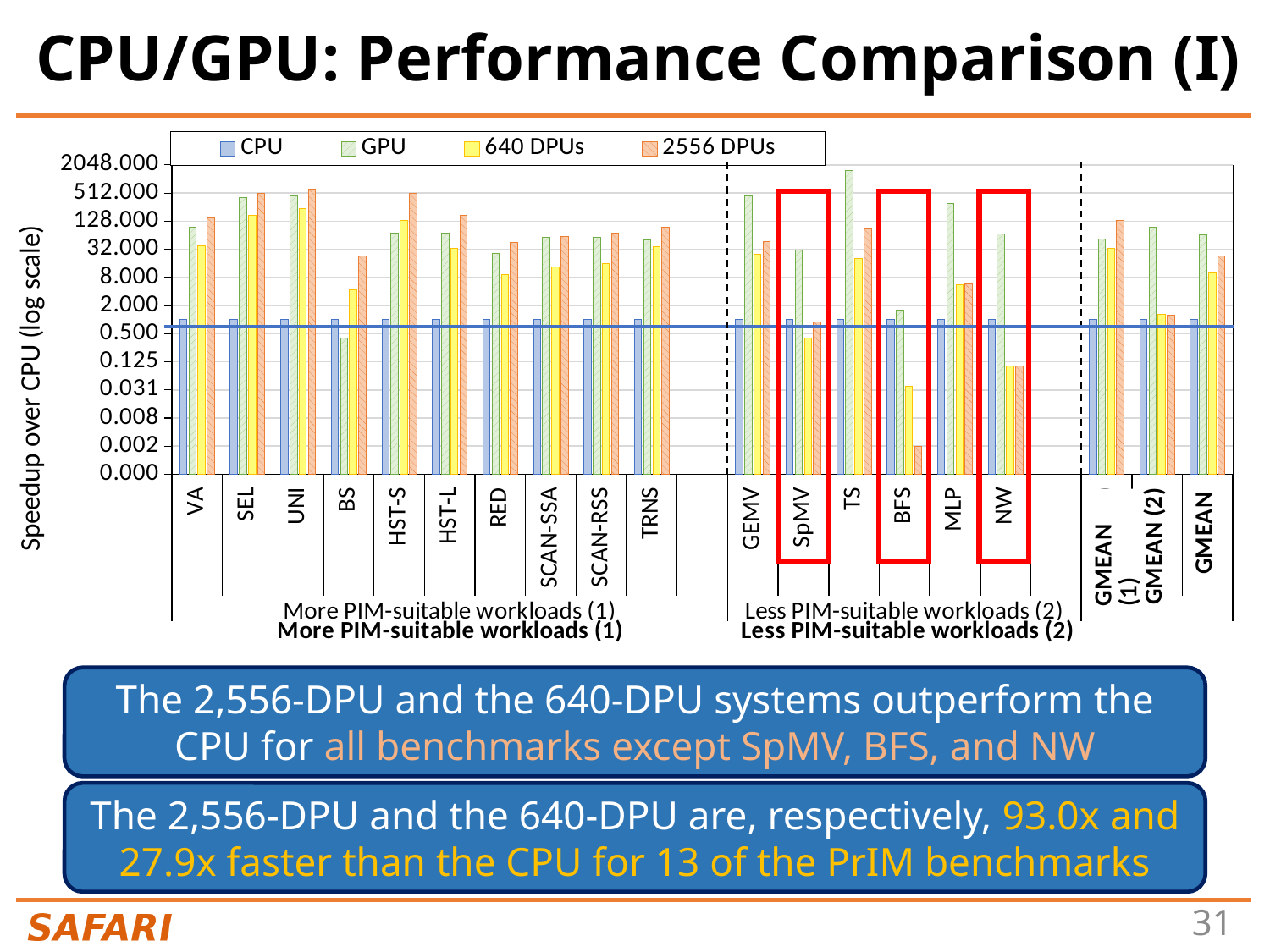
How many benchmark categories (including the GMEAN entries) are shown along the x axis? 19 How many series does the legend list? 4 What kind of chart is shown on the slide? bar chart What is the label of the y axis? Speedup over CPU (log scale) Which benchmark has the lowest 2556 DPUs speedup? BFS Which benchmark has the highest GPU speedup? TS Is the GPU value for TS greater or less than 512.000? greater Is the 2556 DPUs value for HST-S greater or less than 128.000? greater Is the 640 DPUs value for NW greater or less than 0.500? less For HST-S, which is larger: the GPU value or the 2556 DPUs value? 2556 DPUs For MLP, which is larger: the GPU value or the 2556 DPUs value? GPU